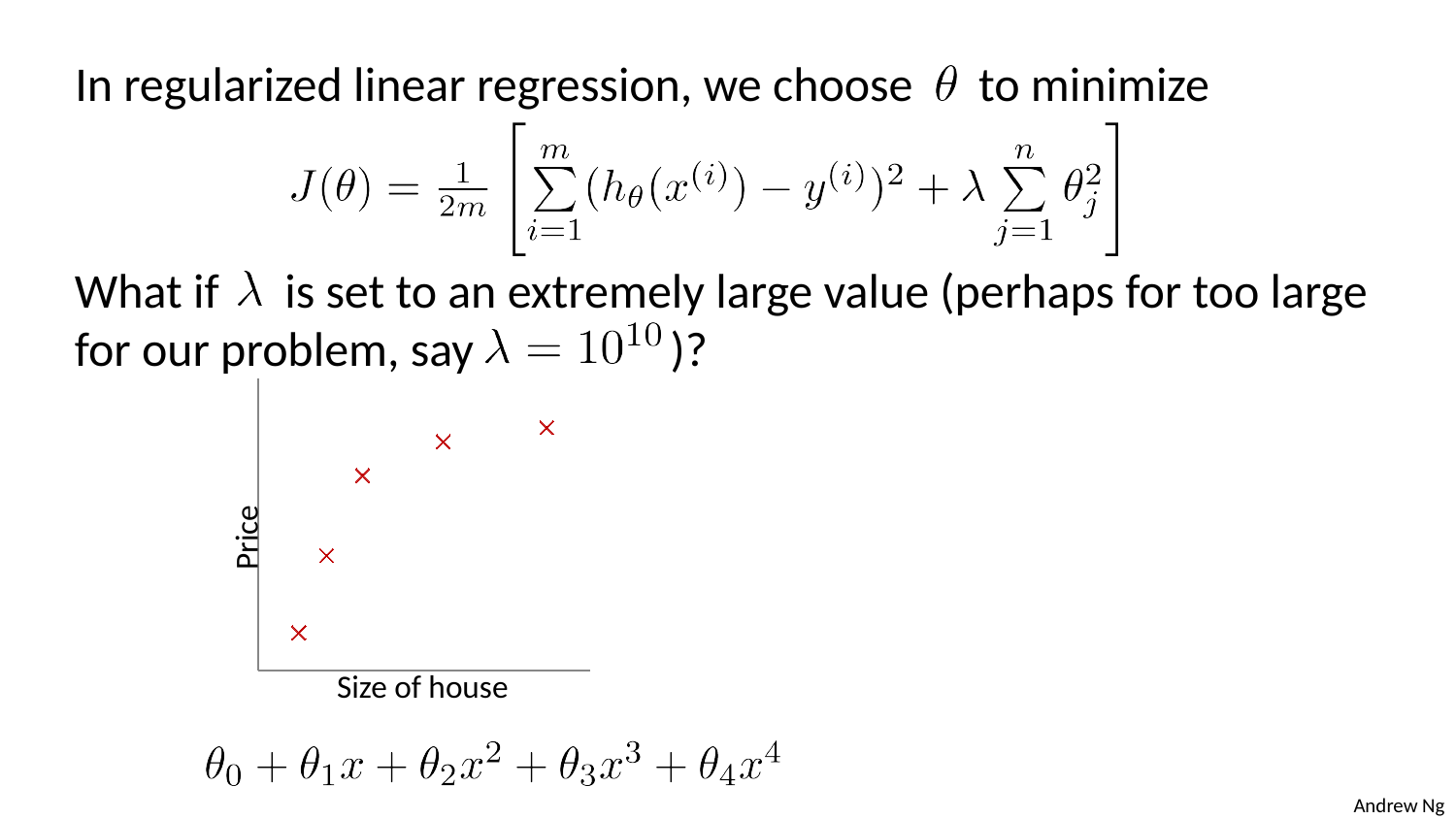
Do the plotted prices rise or fall as the size of house increases along the x axis? rise Does the point with the largest size of house have a higher or lower price than the point with the smallest size of house? higher What is the label of the x axis of the chart? Size of house How many data points are plotted on the chart? 5 What is the label of the y axis of the chart? Price What kind of chart is shown on the slide? scatter plot